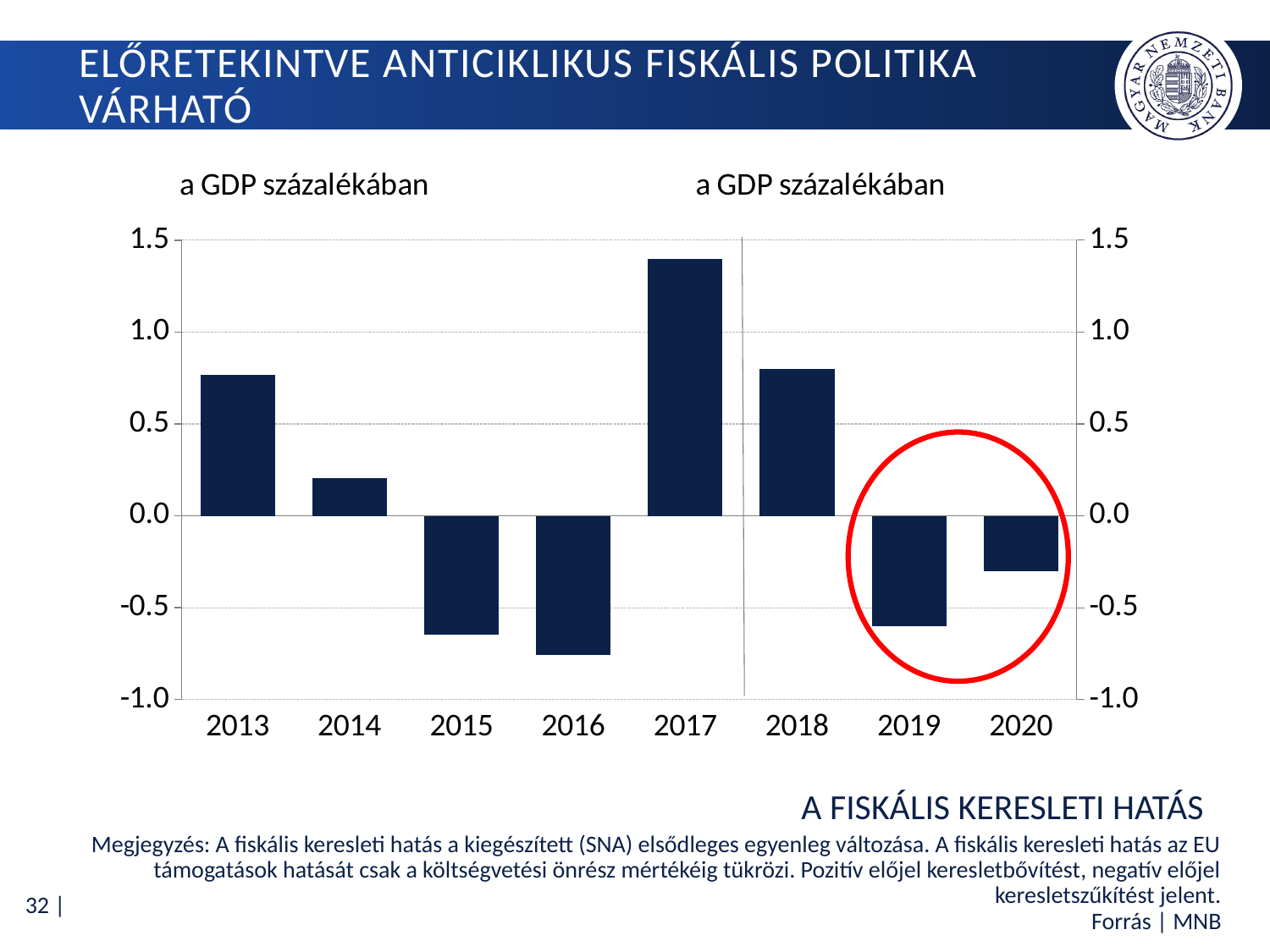
Which is larger, the value for 2019 or the value for 2020? 2020 Is the value for 2017 greater or less than 1.0? greater What kind of chart is shown on the slide? bar chart How many years are shown on the x axis of the chart? 8 Is the value for 2015 greater or less than -0.5? less Which is larger, the value for 2013 or the value for 2014? 2013 What is the title of the chart, shown below it? A FISKÁLIS KERESLETI HATÁS Is the value for 2020 greater or less than -0.5? greater Which years are highlighted by the red circle on the chart? 2019 and 2020 Which year has the highest value in the chart? 2017 Which year has the lowest value in the chart? 2016